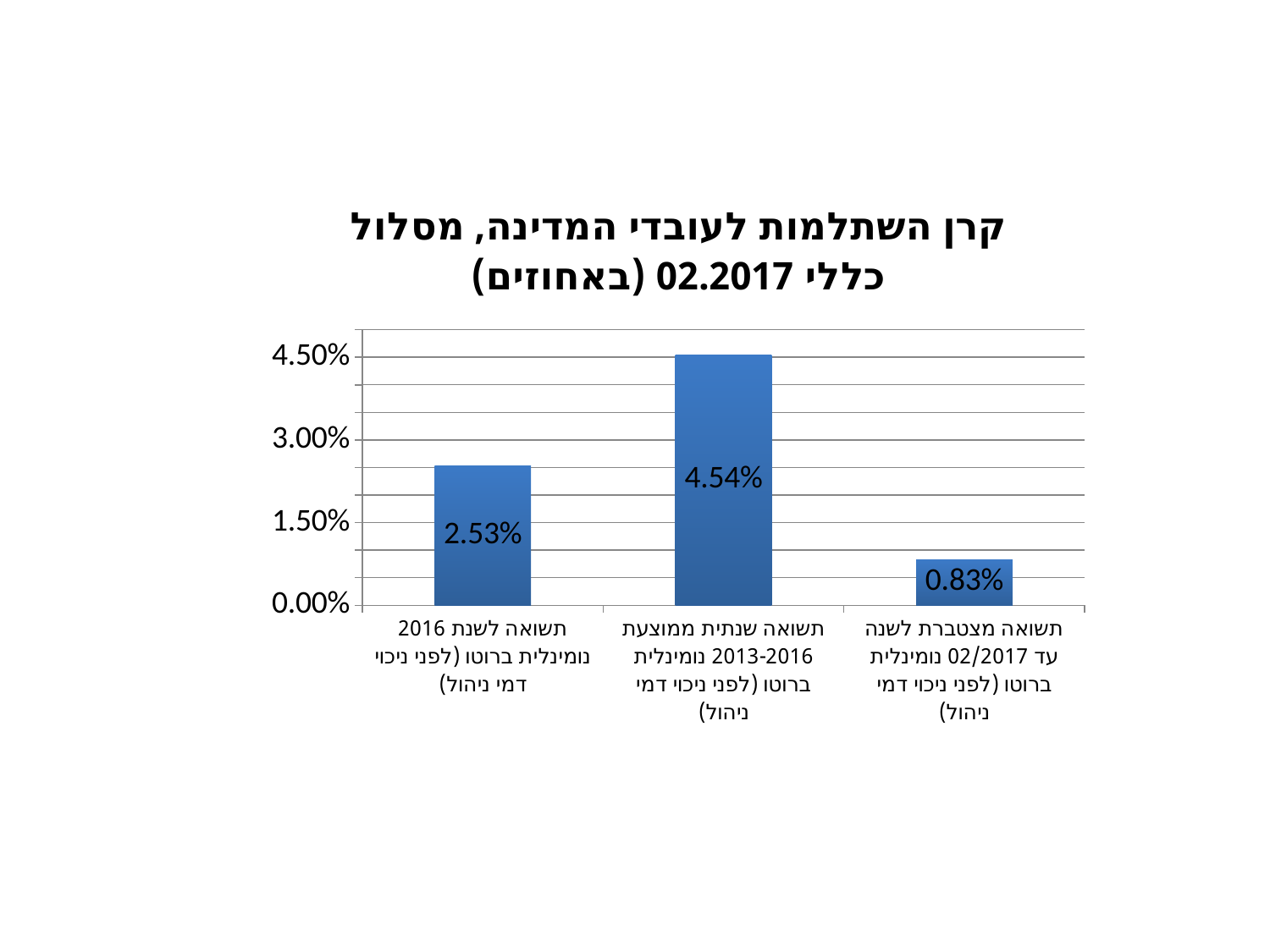
What is the difference between the value for "תשואה שנתית ממוצעת 2013-2016" and the value for "תשואה לשנת 2016"? 2.01% What is the difference between the value for "תשואה לשנת 2016" and the value for "תשואה מצטברת לשנה עד 02/2017"? 1.70% How many categories are shown in the chart? 3 What kind of chart is shown on the slide? Bar chart What is the value for "תשואה לשנת 2016 נומינלית ברוטו (לפני ניכוי דמי ניהול)"? 2.53% Which is larger: the value for "תשואה לשנת 2016" or the value for "תשואה מצטברת לשנה עד 02/2017"? תשואה לשנת 2016 Which category has the highest value? תשואה שנתית ממוצעת 2013-2016 נומינלית ברוטו (לפני ניכוי דמי ניהול) Which category has the lowest value? תשואה מצטברת לשנה עד 02/2017 נומינלית ברוטו (לפני ניכוי דמי ניהול) What is the value for "תשואה שנתית ממוצעת 2013-2016 נומינלית ברוטו (לפני ניכוי דמי ניהול)"? 4.54% Is the value for "תשואה שנתית ממוצעת 2013-2016" greater or less than 3.00%? greater What is the value for "תשואה מצטברת לשנה עד 02/2017 נומינלית ברוטו (לפני ניכוי דמי ניהול)"? 0.83% What is the title of the chart? קרן השתלמות לעובדי המדינה, מסלול כללי 02.2017 (באחוזים)